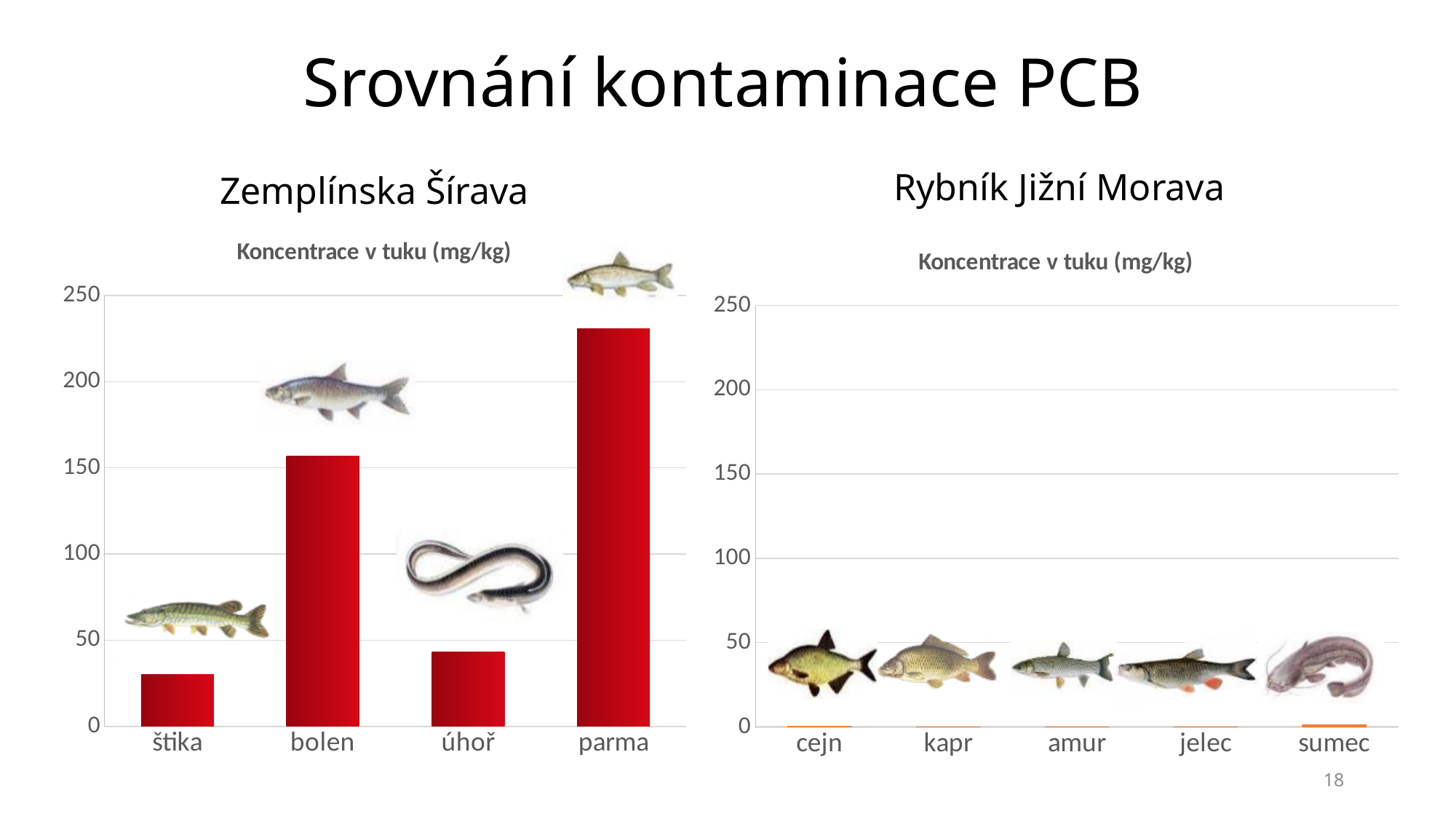
On the Zemplínska Šírava chart, is the value for štika greater or less than 50? less On the Rybník Jižní Morava chart, is the value for kapr greater or less than 50? less On the Zemplínska Šírava chart, which is larger, the value for bolen or the value for úhoř? bolen What unit is used on the vertical axis of the Zemplínska Šírava chart, according to its title? mg/kg What is the title of the chart on the right side of the slide? Koncentrace v tuku (mg/kg) What kind of chart is the Zemplínska Šírava chart? bar chart On the Zemplínska Šírava chart, is the value for parma greater or less than 200? greater How many fish species are shown on the Zemplínska Šírava chart? 4 How many fish species are shown on the Rybník Jižní Morava chart? 5 On the Zemplínska Šírava chart, which fish has the highest concentration? parma On the Zemplínska Šírava chart, which fish has the lowest concentration? štika